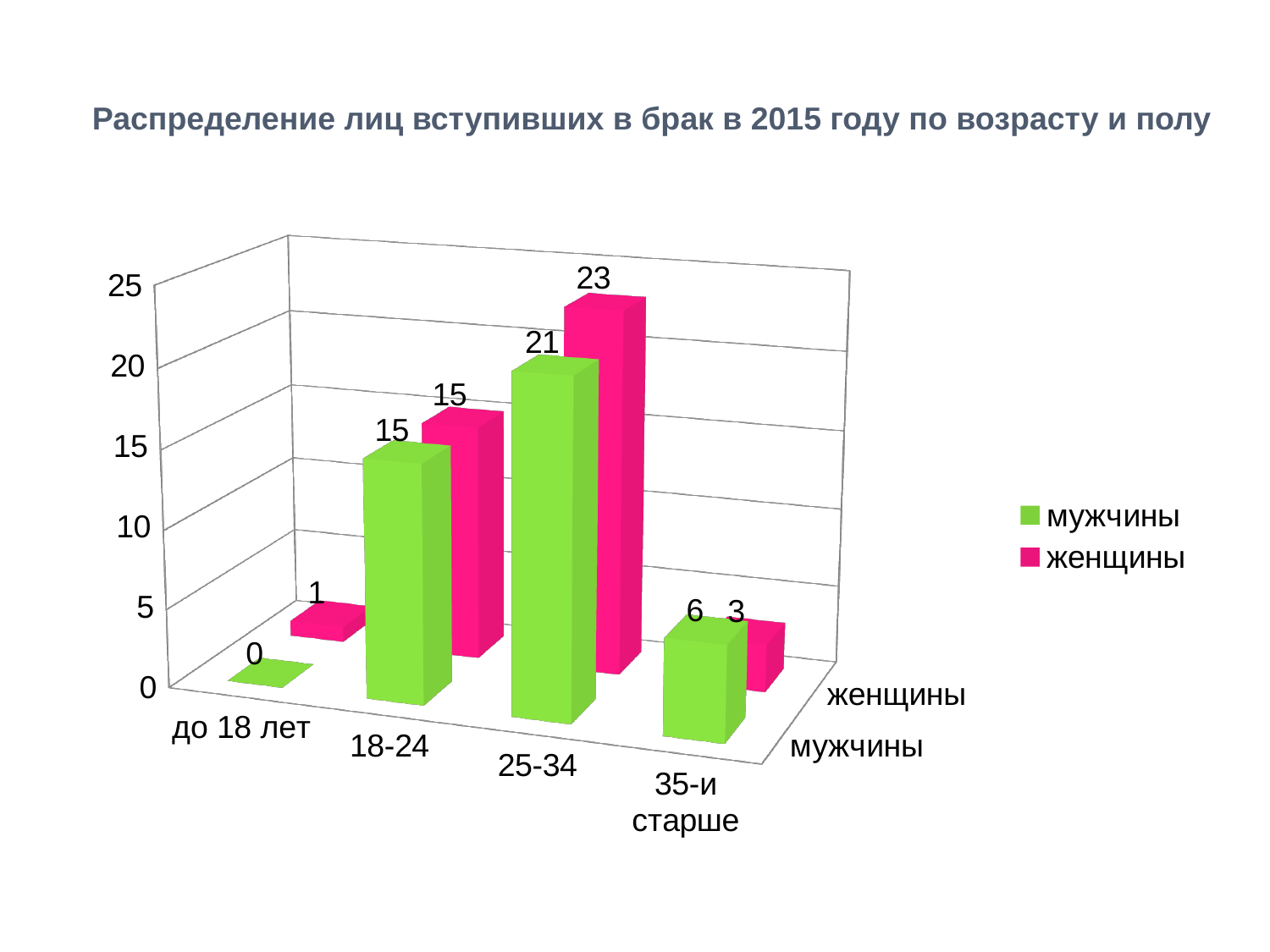
How many series does the legend list? 2 What is the value for женщины in the до 18 лет age group? 1 How many age groups are shown on the x axis? 4 What is the value for мужчины in the 25-34 age group? 21 What is the difference between женщины and мужчины in the 25-34 age group? 2 What is the value for женщины in the 18-24 age group? 15 Which is larger in the 35-и старше age group, мужчины or женщины? мужчины What is the value for мужчины in the 35-и старше age group? 6 Which age group has the lowest value for мужчины? до 18 лет What kind of chart is shown on the slide? bar chart What colour represents женщины in the chart? pink Which age group has the highest value for женщины? 25-34